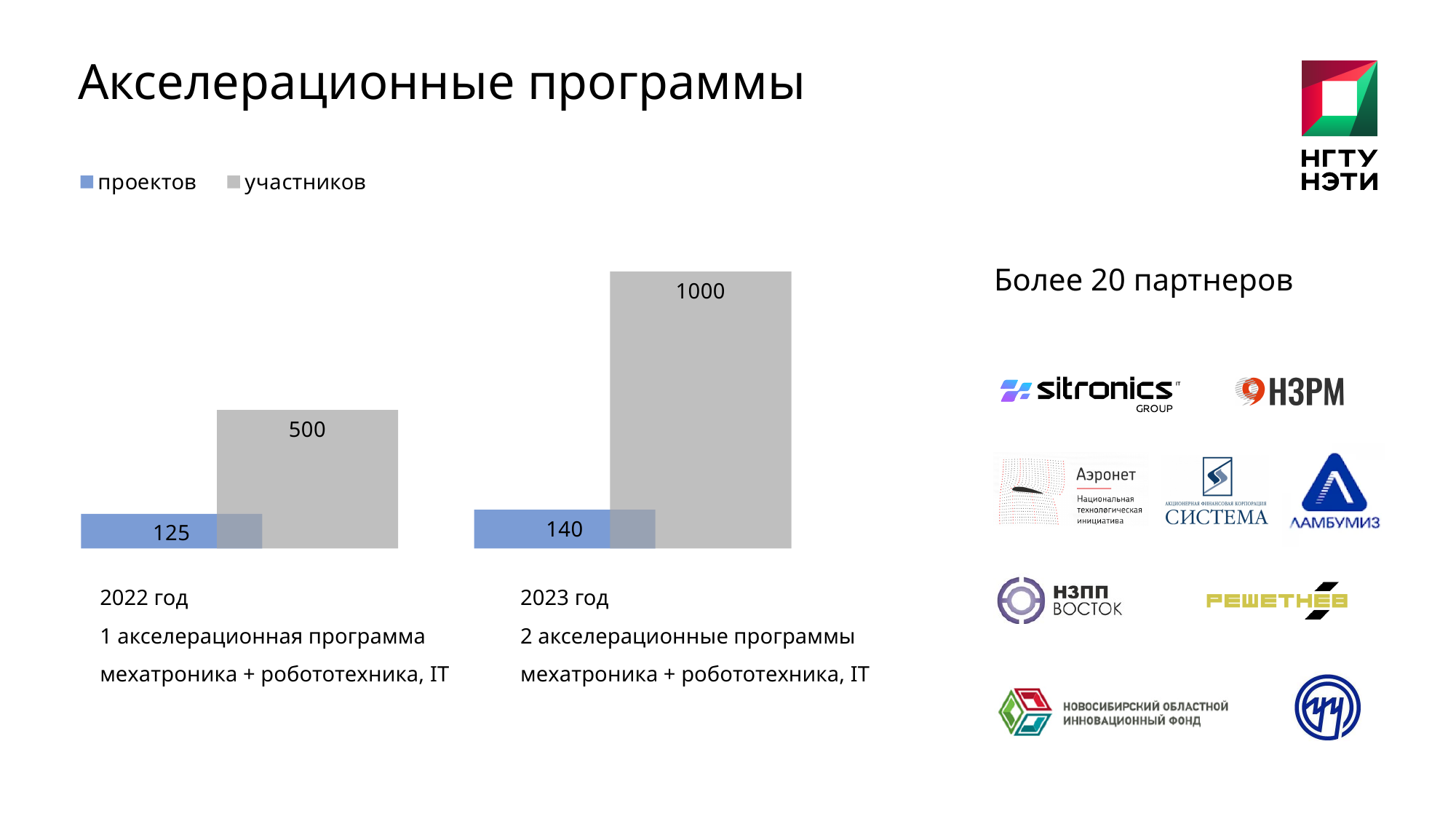
What is the value of участников for 2022 год? 500 What type of chart is shown on the slide? Bar chart Which year has the higher number of участников? 2023 год How many projects (проектов) are shown for 2022 год? 125 What is the difference in участников between 2023 год and 2022 год? 500 How many participants (участников) are shown for 2023 год? 1000 What is the difference in проектов between 2023 год and 2022 год? 15 How many series does the chart legend list? 2 Which series is shown in blue in the chart legend? проектов Which year has the lower number of проектов? 2022 год Is the number of проектов larger in 2022 год or 2023 год? 2023 год What is the value of проектов for 2023 год? 140